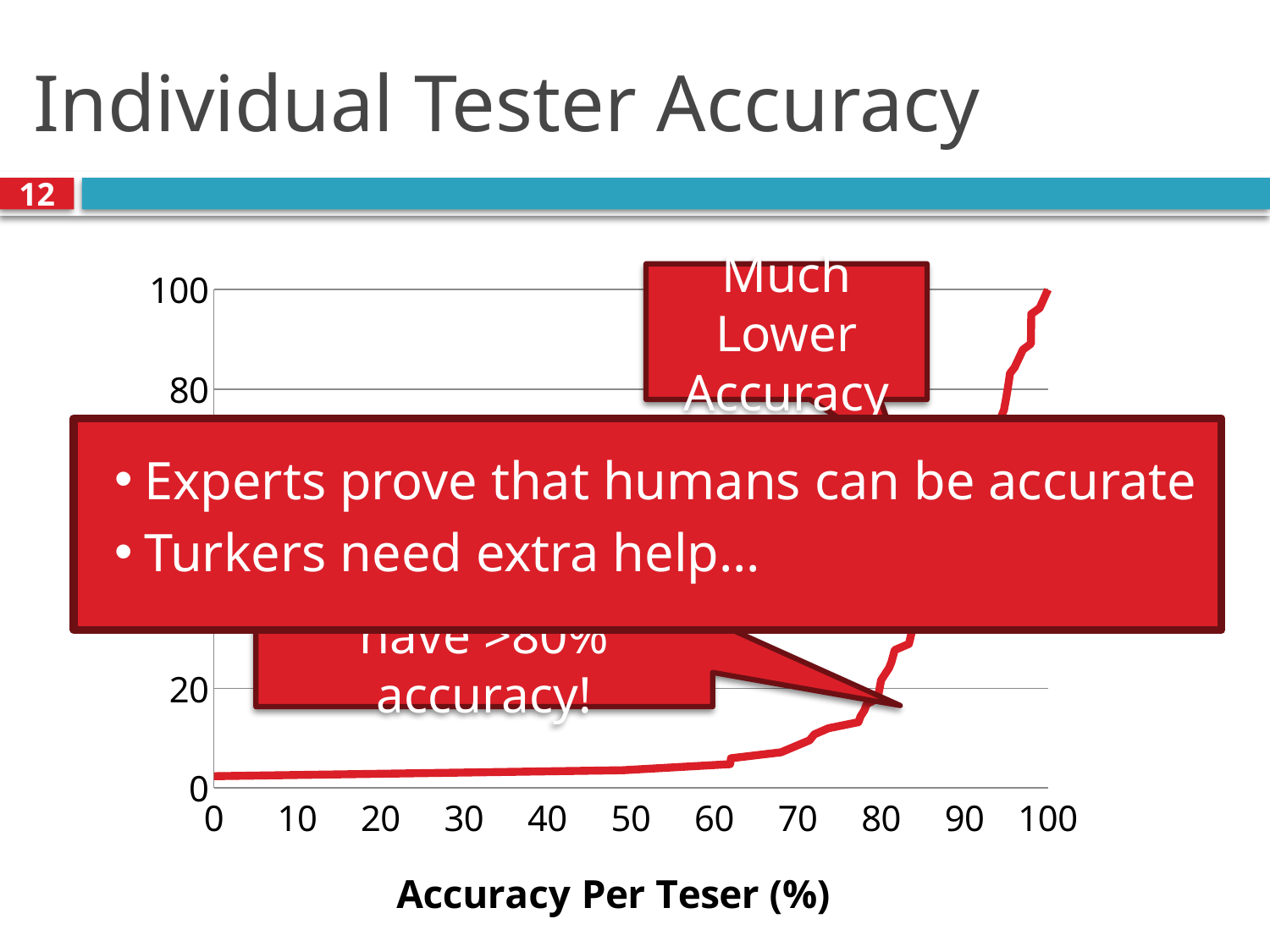
Is the plotted value at an Accuracy Per Teser of 10% greater or less than 20? less Do the plotted values rise or fall as Accuracy Per Teser (%) increases along the x axis? rise What is the highest tick value shown on the y axis of the chart? 100 What is the label of the x axis of the chart? Accuracy Per Teser (%) Is the plotted value at an Accuracy Per Teser of 50% greater or less than 20? less Is the plotted value at an Accuracy Per Teser of 30% greater or less than 20? less What kind of chart is shown on the slide? line chart Which of the two x-axis positions, 60% or 100%, has the larger plotted value? 100%